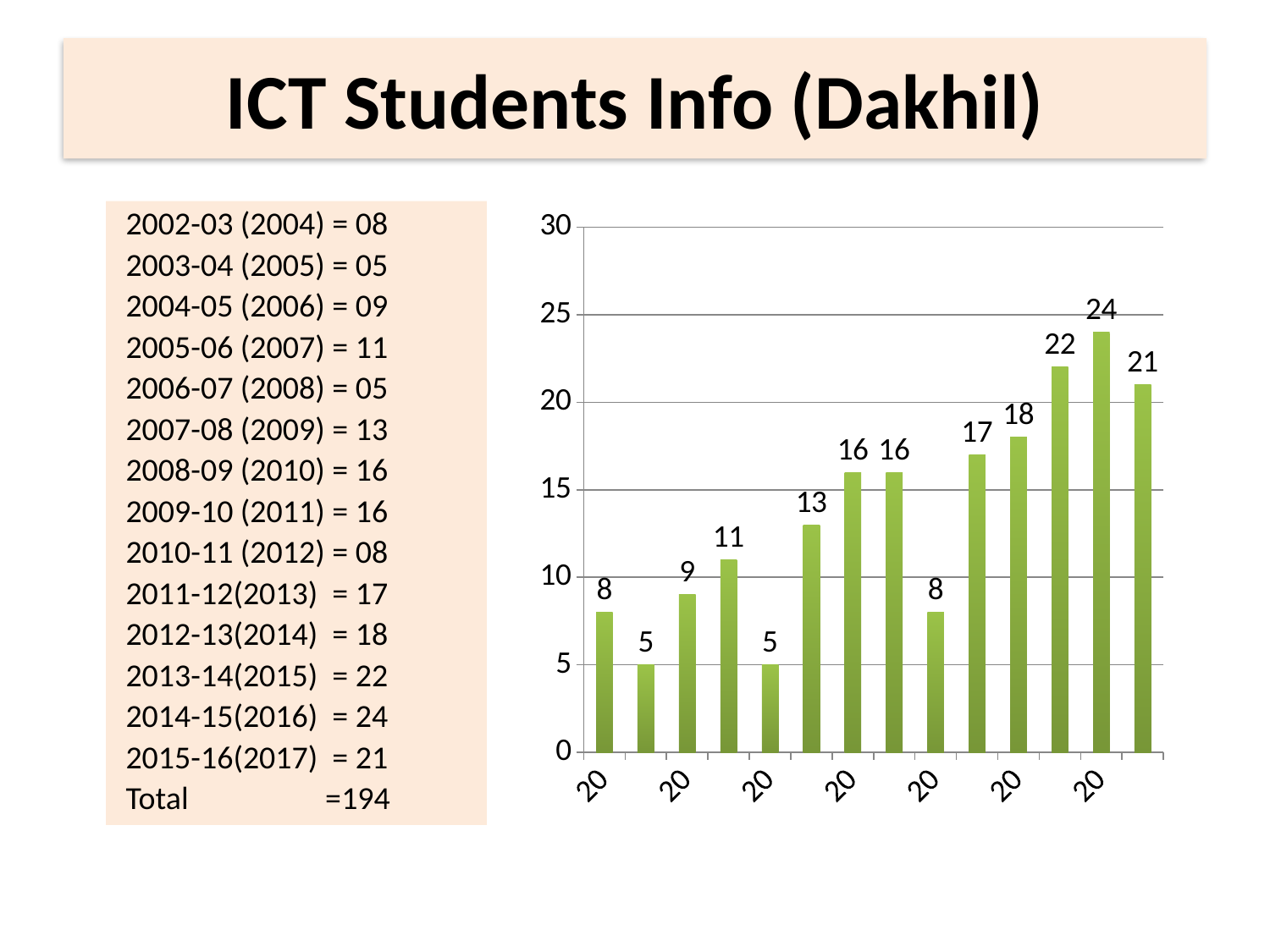
What is the highest value shown on the chart's vertical axis? 30 What is the value of the tallest bar in the chart? 24 How many bars are plotted in the chart? 14 What is the value of the sixth bar from the left in the chart? 13 Is the value of the twelfth bar from the left greater or less than 20? greater What type of chart is shown on the slide? bar chart What is the difference between the tallest bar (24) and the rightmost bar (21)? 3 What is the value of the last (rightmost) bar in the chart? 21 What is the lowest value shown by any bar in the chart? 5 What is the value of the first (leftmost) bar in the chart? 8 Do the values generally rise or fall from the left of the chart to the right? rise Which is larger, the value of the tenth bar from the left or the value of the eleventh bar from the left? the eleventh bar (18)